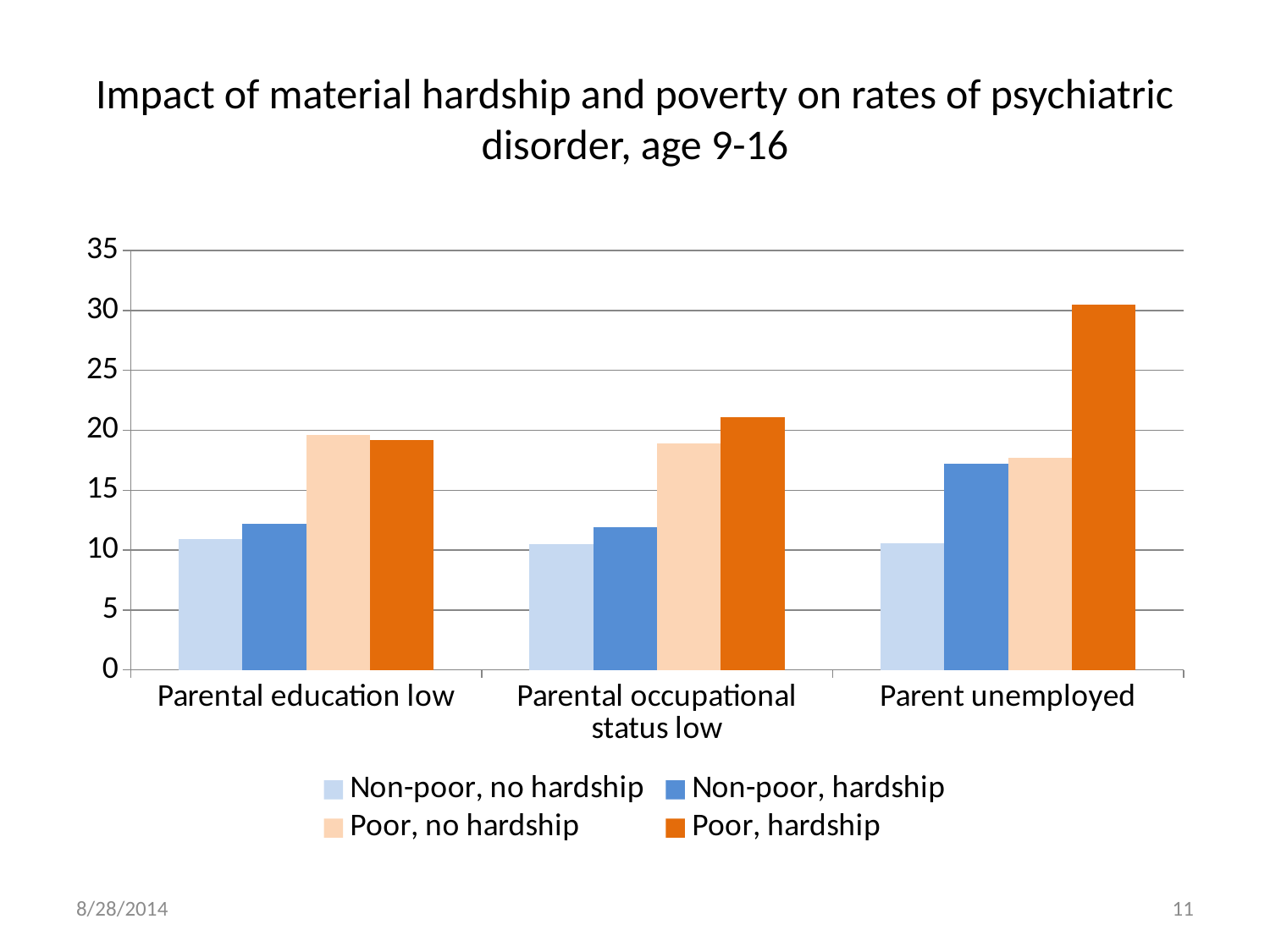
Within the Parent unemployed category, which series has the lowest value? Non-poor, no hardship How many categories are shown on the x axis? 3 Which category has the highest value for the Poor, hardship series? Parent unemployed In the Parent unemployed category, which is larger: Poor, hardship or Non-poor, hardship? Poor, hardship Is the value for Non-poor, hardship in the Parent unemployed category greater or less than 15? greater Within the Parental occupational status low category, which series has the highest value? Poor, hardship Is the value for Non-poor, no hardship in the Parental education low category greater or less than 15? less How many series does the legend list? 4 What kind of chart is shown on the slide? bar chart What is the title of the chart? Impact of material hardship and poverty on rates of psychiatric disorder, age 9-16 Is the value for Poor, hardship in the Parent unemployed category greater or less than 25? greater